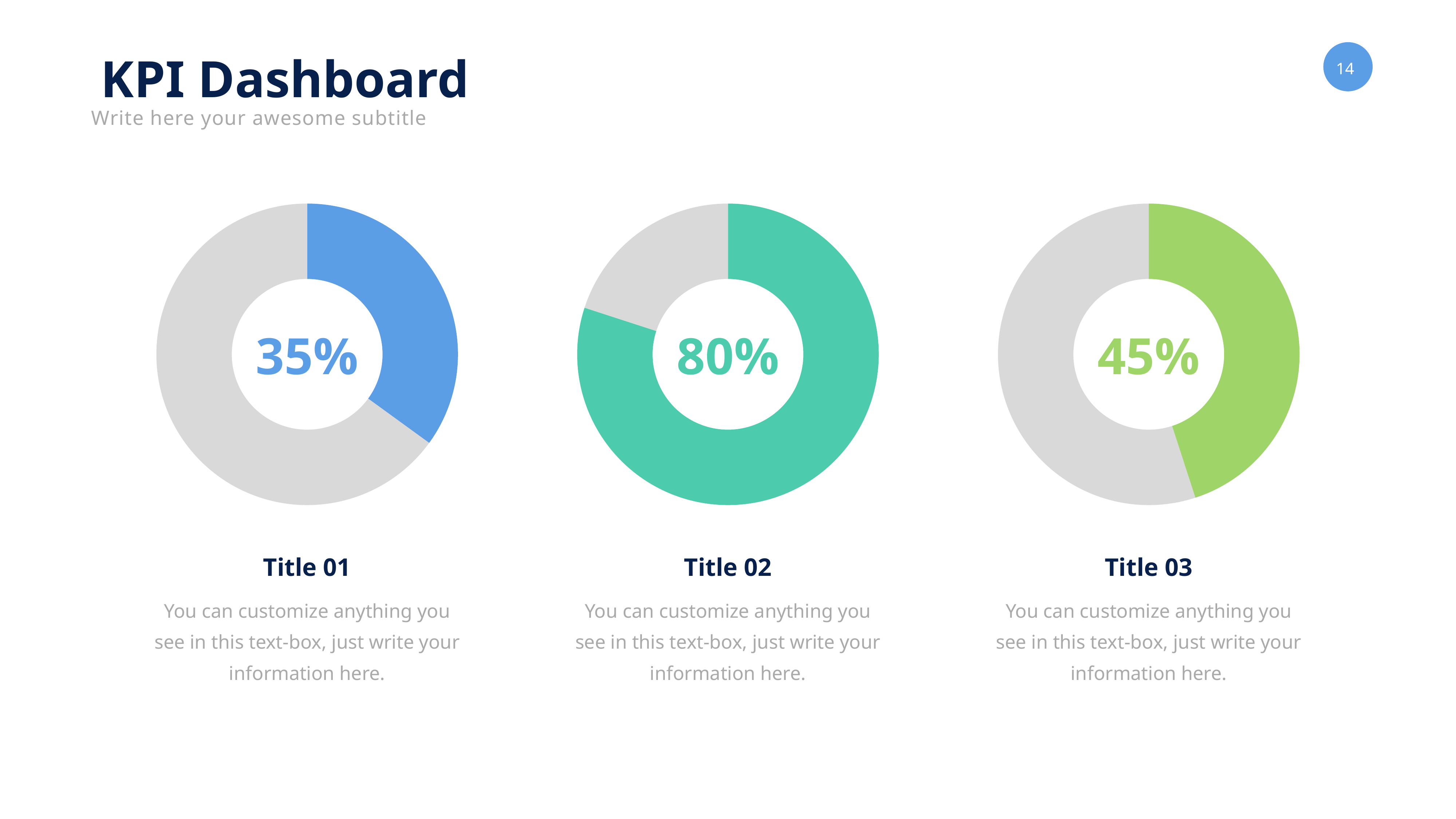
What percentage is shown in the centre of the Title 02 donut chart? 80% Which of the three donut charts (Title 01, Title 02, Title 03) shows the lowest percentage? Title 01 What percentage is shown in the centre of the Title 03 donut chart? 45% Which is larger, the percentage in the Title 03 chart or the percentage in the Title 01 chart? Title 03 What is the difference between the percentage in the Title 02 chart and the percentage in the Title 01 chart? 45% How many donut charts are shown on the slide? 3 What is the difference between the percentage in the Title 03 chart and the percentage in the Title 01 chart? 10% What is the title of the slide containing the three donut charts? KPI Dashboard What kind of chart is used for Title 01, Title 02 and Title 03? Donut chart What percentage is shown in the centre of the Title 01 donut chart? 35% What colour is the filled portion of the Title 02 donut chart? Teal/green Which of the three donut charts (Title 01, Title 02, Title 03) shows the highest percentage? Title 02